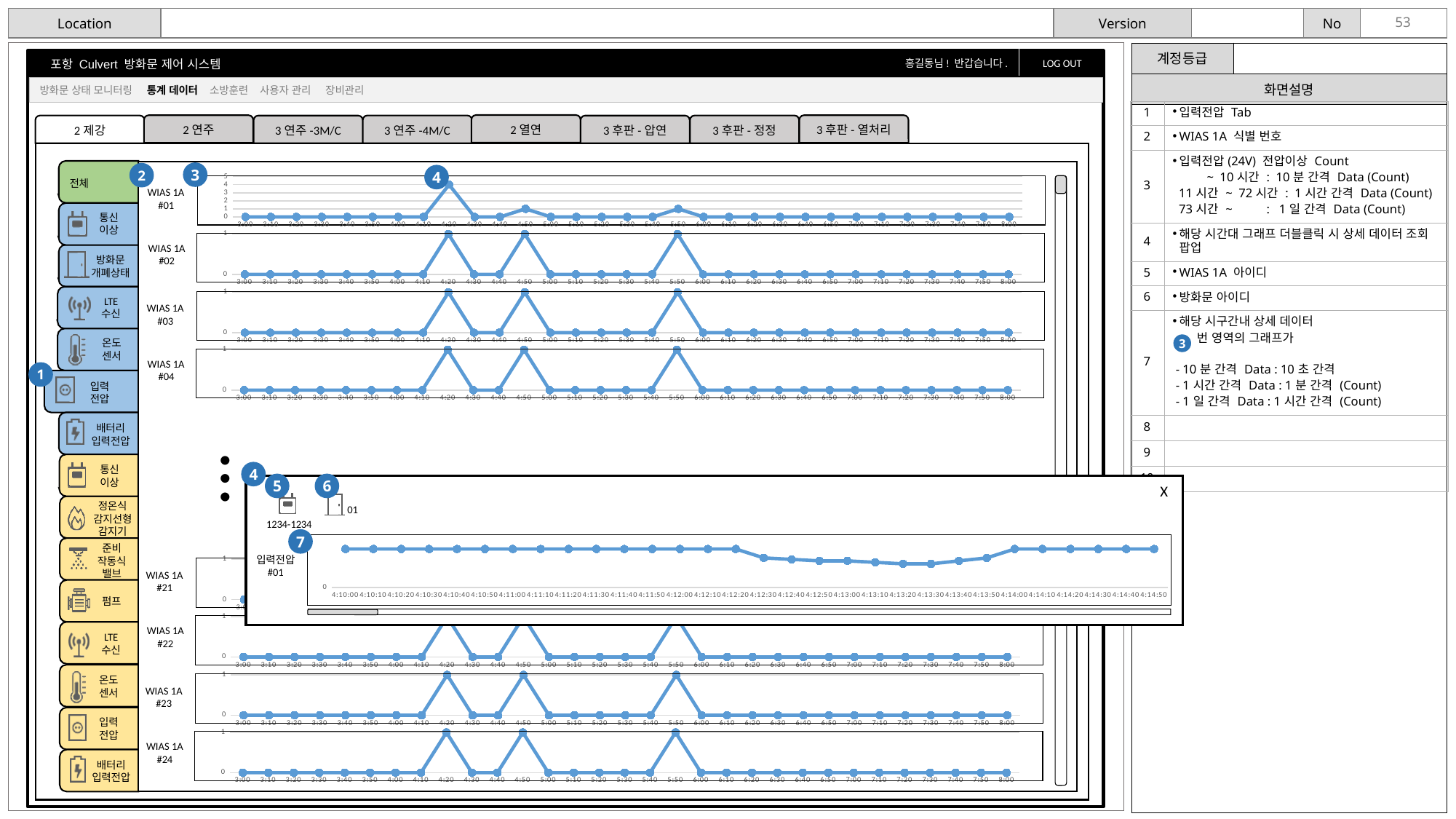
On the WIAS 1A #01 chart, which is larger, the value at 4:20 or the value at 4:50? 4:20 On the WIAS 1A #03 chart, at which three times does the line rise to 1? 4:20, 4:50, 5:50 What kind of chart is used for WIAS 1A #02? line chart What is the first time label on the x axis of the popup chart labelled 입력전압 #01? 4:10:00 On the WIAS 1A #02 chart, what is the value at 4:20? 1 On the WIAS 1A #02 chart, what is the value at 3:00? 0 On the WIAS 1A #01 chart, what is the highest value shown on the y axis? 5 On the WIAS 1A #01 chart, at which time does the line reach its highest value? 4:20 On the WIAS 1A #22 chart, what is the value at 6:00? 0 On the WIAS 1A #23 chart, is the value at 4:20 greater or less than the value at 4:30? greater What is the first time label on the x axis of the WIAS 1A #04 chart? 3:00 What is the last time label on the x axis of the WIAS 1A #24 chart? 8:00